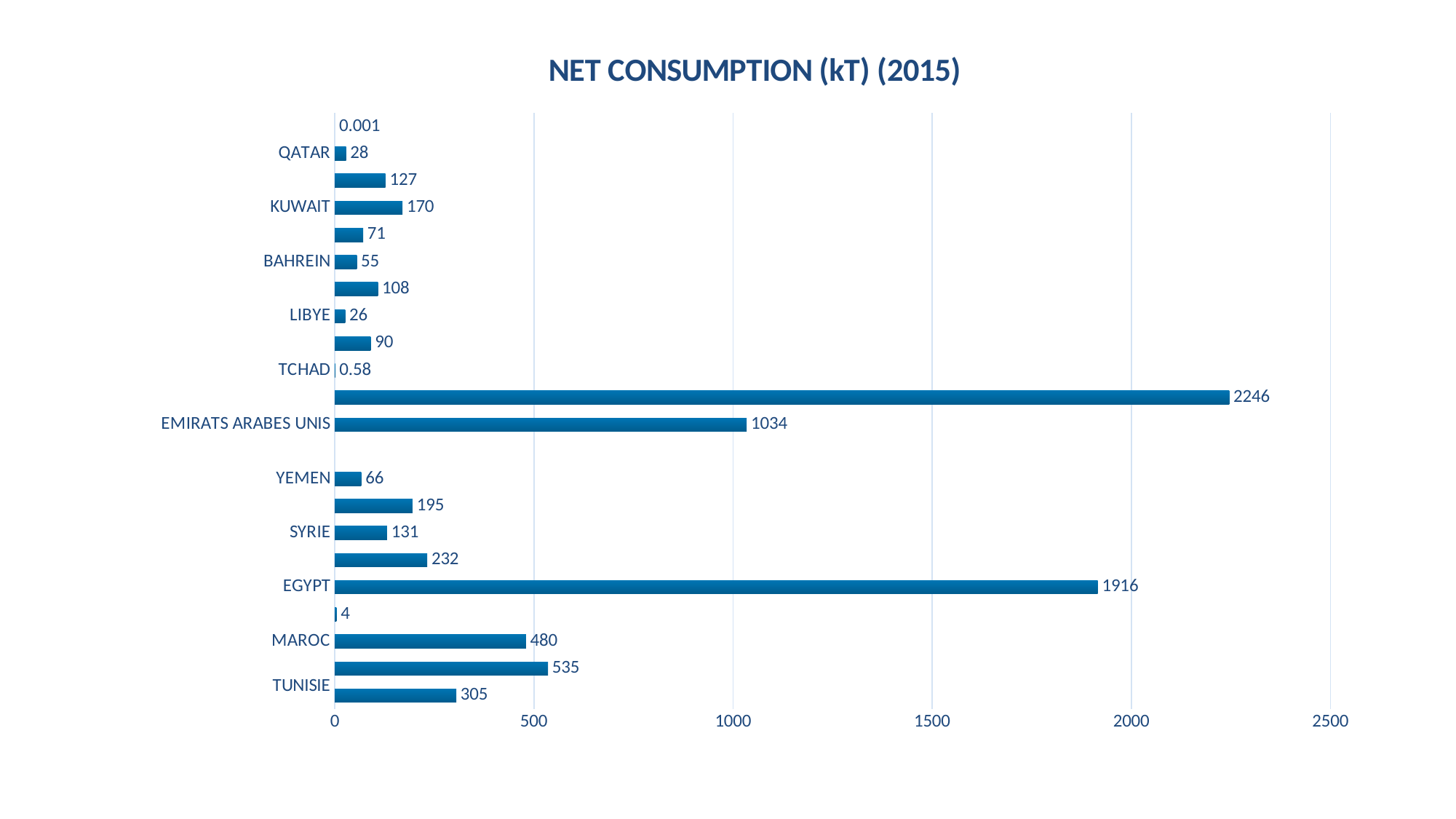
What is the net consumption value for KUWAIT? 170 What is the net consumption value for EGYPT? 1916 What is the difference between the values for EGYPT and EMIRATS ARABES UNIS? 882 Is the value for EGYPT greater or less than 1500? greater What is the net consumption value for MAROC? 480 What is the net consumption value for EMIRATS ARABES UNIS? 1034 What is the net consumption value for TCHAD? 0.58 What is the difference between the values for MAROC and TUNISIE? 175 What kind of chart is shown on the slide? Bar chart Which has a larger value, SYRIE or YEMEN? SYRIE Which has a larger value, QATAR or BAHREIN? BAHREIN What is the title of the chart? NET CONSUMPTION (kT) (2015)